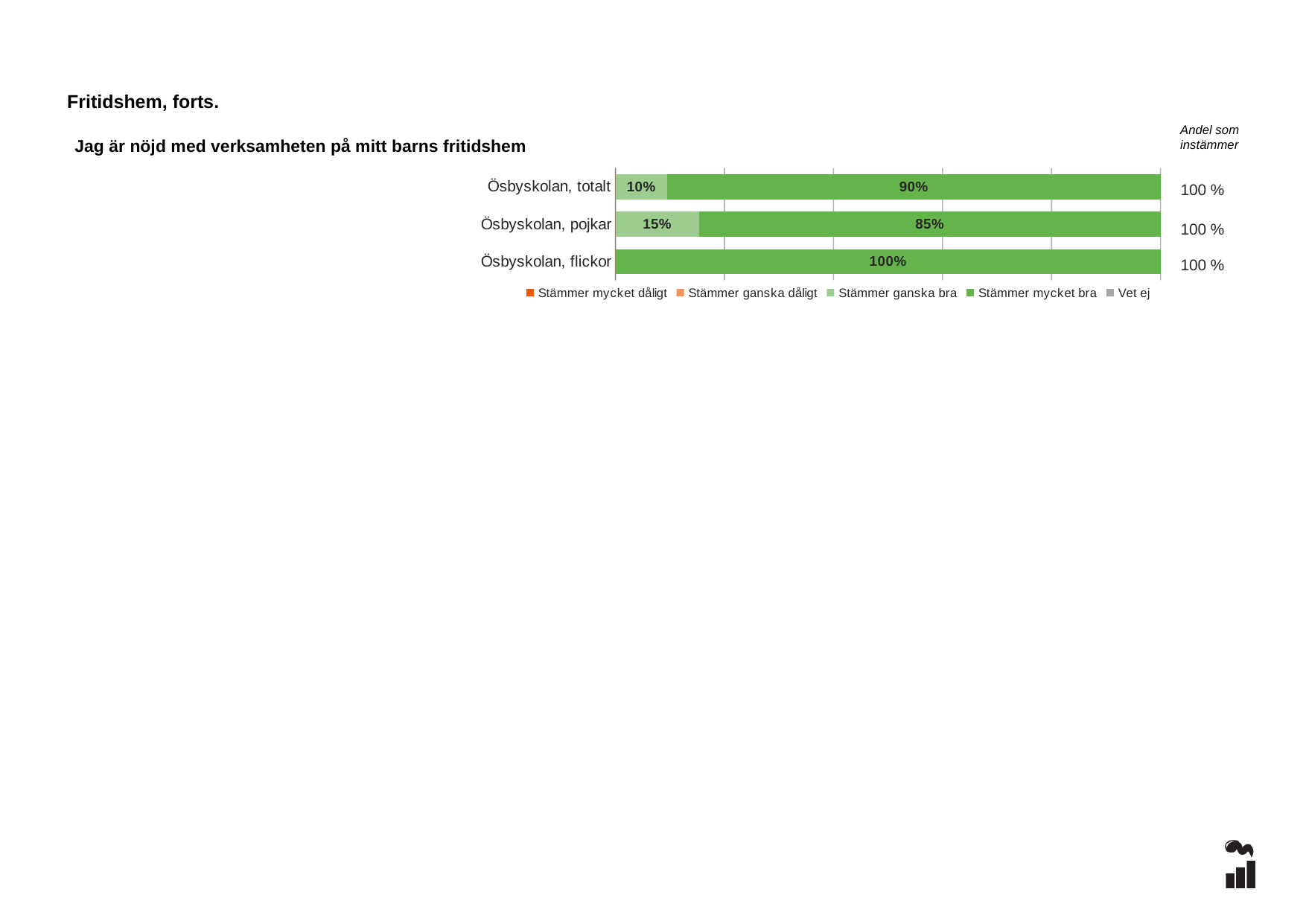
How many categories are shown on the chart? 3 What is the value of "Stämmer ganska bra" for Ösbyskolan, totalt? 10% Which category has the highest value for "Stämmer mycket bra"? Ösbyskolan, flickor What kind of chart is shown on the slide? Stacked bar chart Which is larger: "Stämmer ganska bra" for Ösbyskolan, pojkar or for Ösbyskolan, totalt? Ösbyskolan, pojkar What is the value of "Stämmer ganska bra" for Ösbyskolan, pojkar? 15% Which category has the lowest value for "Stämmer mycket bra"? Ösbyskolan, pojkar What is the value of "Stämmer mycket bra" for Ösbyskolan, totalt? 90% What is the "Andel som instämmer" value shown for Ösbyskolan, pojkar? 100 % How many series does the legend list? 5 What is the difference between the "Stämmer mycket bra" values for Ösbyskolan, totalt and Ösbyskolan, pojkar? 5% What is the value of "Stämmer mycket bra" for Ösbyskolan, flickor? 100%